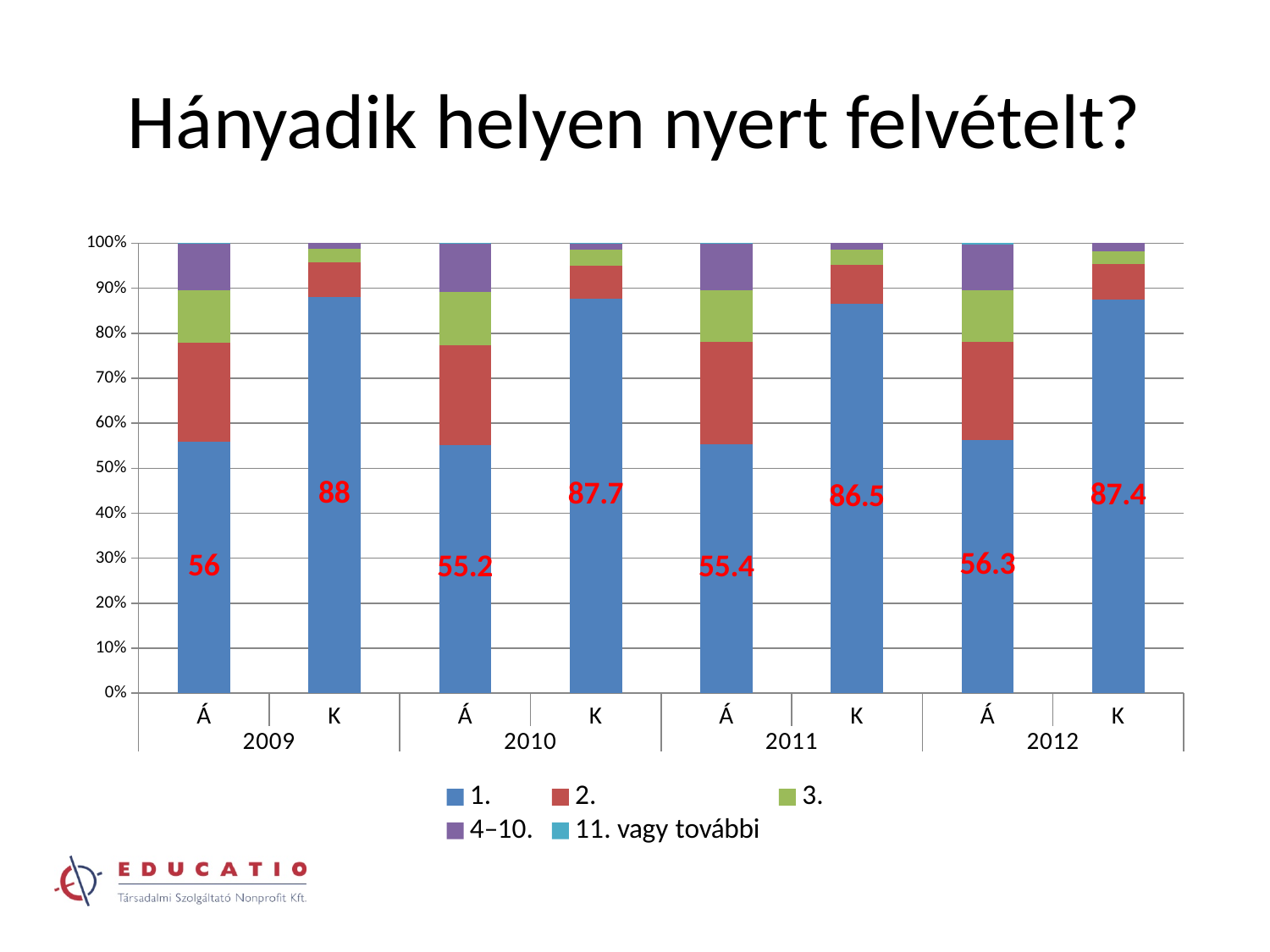
How many bars are plotted in the chart? 8 What is the difference between the "1." series values for K and Á in 2012? 31.1 Which bar has the highest value for the "1." series? K 2009 What is the value of the "1." series for K in 2011? 86.5 How many series does the legend list? 5 What is the value of the "1." series for Á in 2010? 55.2 Which is larger, the "1." series value for Á in 2011 or for Á in 2009? Á 2009 What type of chart is shown on the slide? stacked bar chart What is the value of the "1." series for K in 2009? 88 Which bar has the lowest value for the "1." series? Á 2010 What is the value of the "1." series for Á in 2012? 56.3 Is the "1." series value for K in 2010 greater or less than 80%? greater